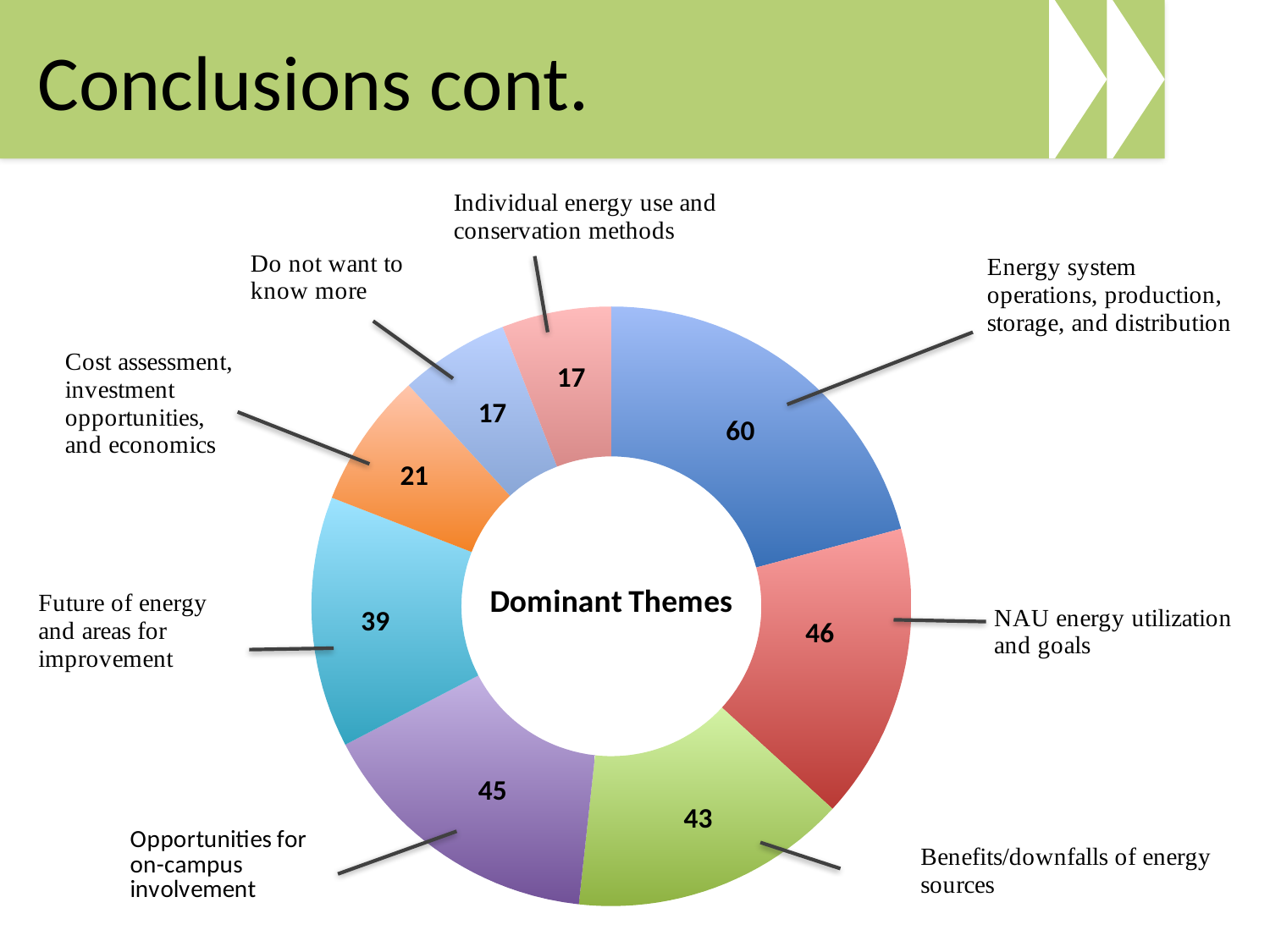
What kind of chart is shown on the slide? Doughnut chart Which has a larger value: 'Opportunities for on-campus involvement' or 'Benefits/downfalls of energy sources'? Opportunities for on-campus involvement What value is shown for 'NAU energy utilization and goals'? 46 What value is shown for 'Future of energy and areas for improvement'? 39 What title is printed in the centre of the chart? Dominant Themes How many slices (themes) does the chart contain? 8 What is the difference between the values for 'Energy system operations, production, storage, and distribution' and 'Future of energy and areas for improvement'? 21 What is the smallest value shown on any slice of the chart? 17 What value is shown for the 'Energy system operations, production, storage, and distribution' slice? 60 Which theme has the highest value in the chart? Energy system operations, production, storage, and distribution What value is shown for 'Cost assessment, investment opportunities, and economics'? 21 What is the sum of all the values shown in the chart? 288